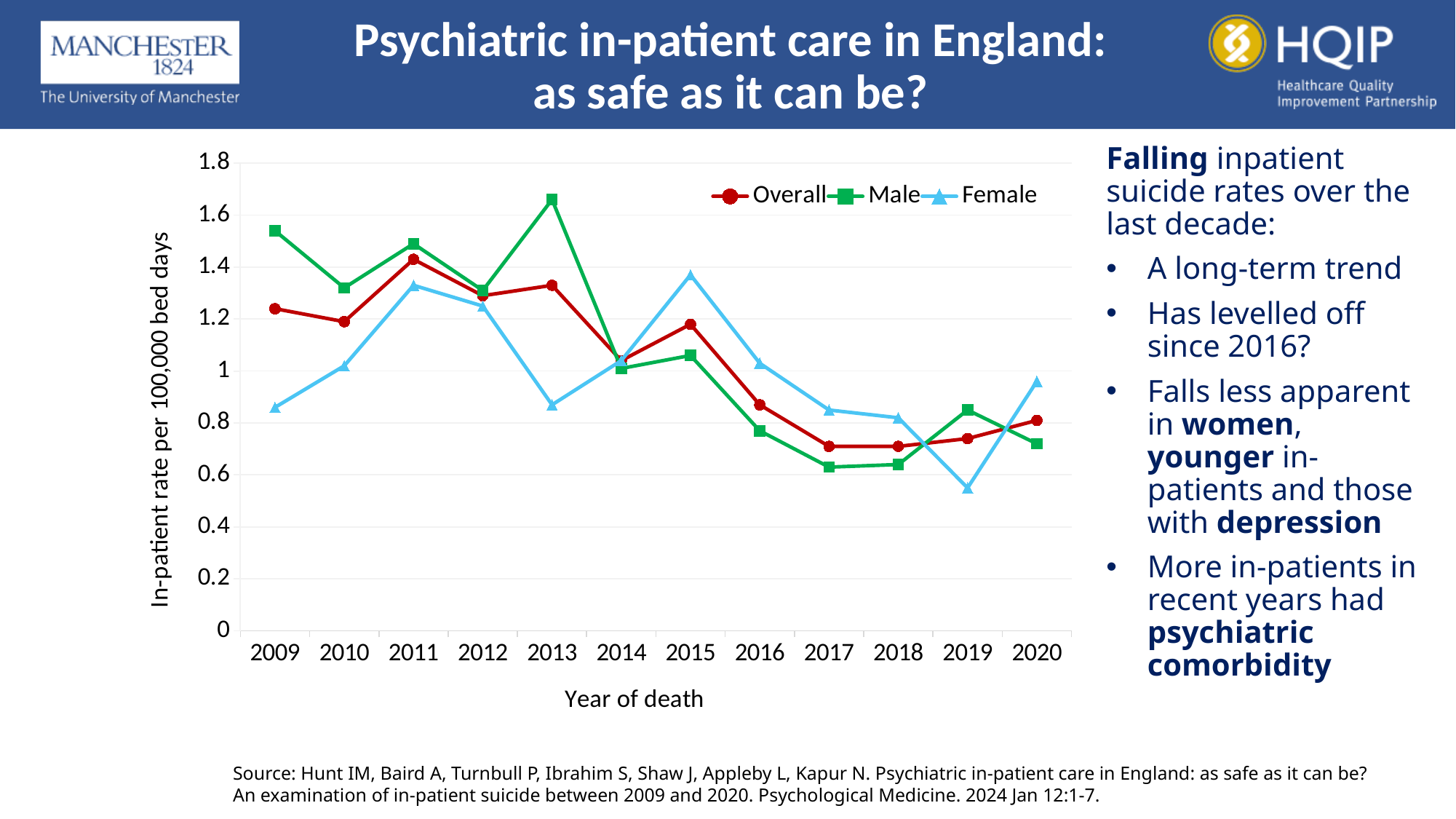
In which year is the Overall in-patient rate highest? 2011 In which year is the Male in-patient rate highest? 2013 Does the Overall in-patient rate generally rise or fall from 2009 to 2020? Fall In which year is the Female in-patient rate lowest? 2019 In 2020, which is larger, the Male rate or the Female rate? Female What is the label on the y axis of the chart? In-patient rate per 100,000 bed days What kind of chart is shown on the slide? Line chart How many years are plotted along the x axis of the chart? 12 How many series does the chart legend list? 3 Is the Male value for 2009 greater or less than 1.4? greater Is the Female value for 2009 greater or less than 1? less Is the Overall value for 2015 greater or less than 1? greater